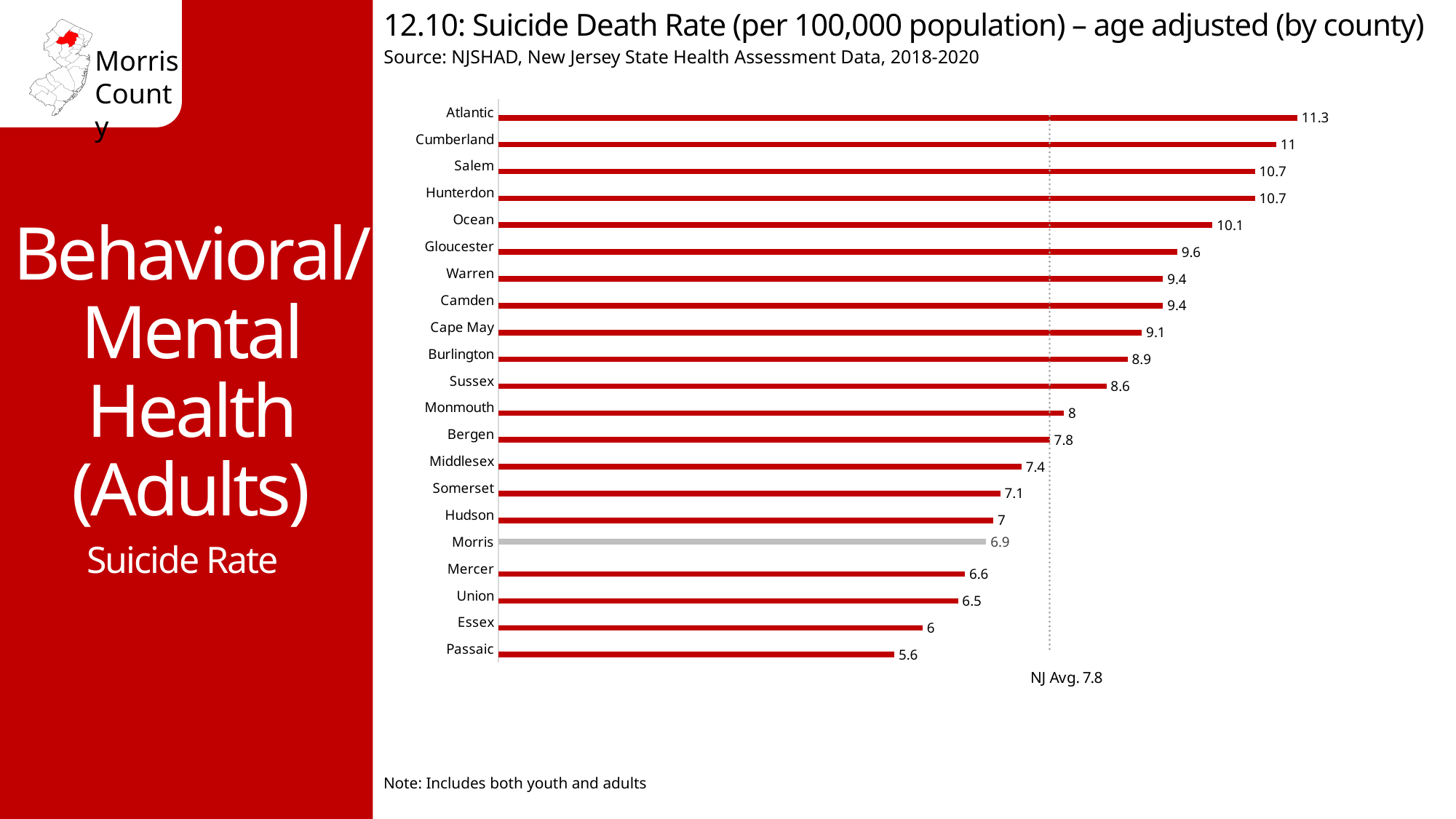
What is the suicide death rate for Bergen County? 7.8 What is the suicide death rate for Atlantic County? 11.3 What is the difference between the suicide death rate of Morris County and the NJ average? 0.9 What type of chart is shown on the slide? Bar chart What is the suicide death rate for Morris County? 6.9 Which county has the highest suicide death rate? Atlantic What is the NJ average suicide death rate marked on the chart? 7.8 Which county has the lowest suicide death rate? Passaic Which county has a higher suicide death rate, Ocean or Gloucester? Ocean What is the difference between the suicide death rates of Atlantic and Passaic counties? 5.7 Which county has a higher suicide death rate, Hudson or Mercer? Hudson How many counties are shown in the chart? 21